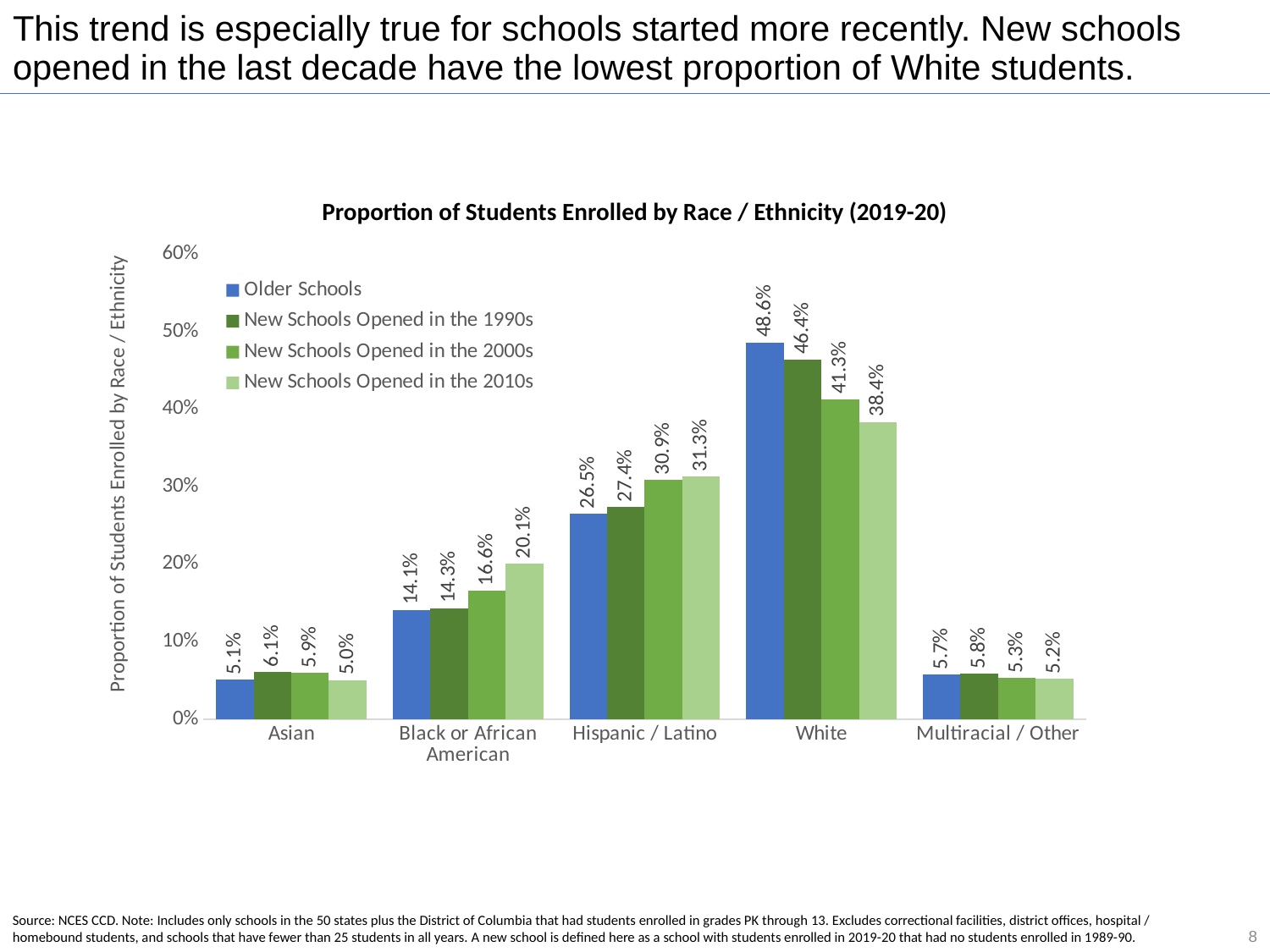
What is the proportion of Black or African American students in New Schools Opened in the 2000s? 16.6% Is the proportion of Black or African American students in New Schools Opened in the 2010s greater or less than 20%? greater Which series has the lowest proportion of White students? New Schools Opened in the 2010s What is the difference between the proportion of White students in Older Schools and in New Schools Opened in the 2010s? 10.2% What kind of chart is shown on the slide? Bar chart What is the proportion of White students in Older Schools? 48.6% Which is larger: the proportion of Asian students in New Schools Opened in the 1990s or in New Schools Opened in the 2010s? New Schools Opened in the 1990s What is the proportion of Hispanic / Latino students in New Schools Opened in the 2010s? 31.3% How many race / ethnicity categories are shown on the x axis? 5 Which race / ethnicity category has the highest proportion for New Schools Opened in the 1990s? White What is the title of the chart? Proportion of Students Enrolled by Race / Ethnicity (2019-20) How many series does the legend list? 4